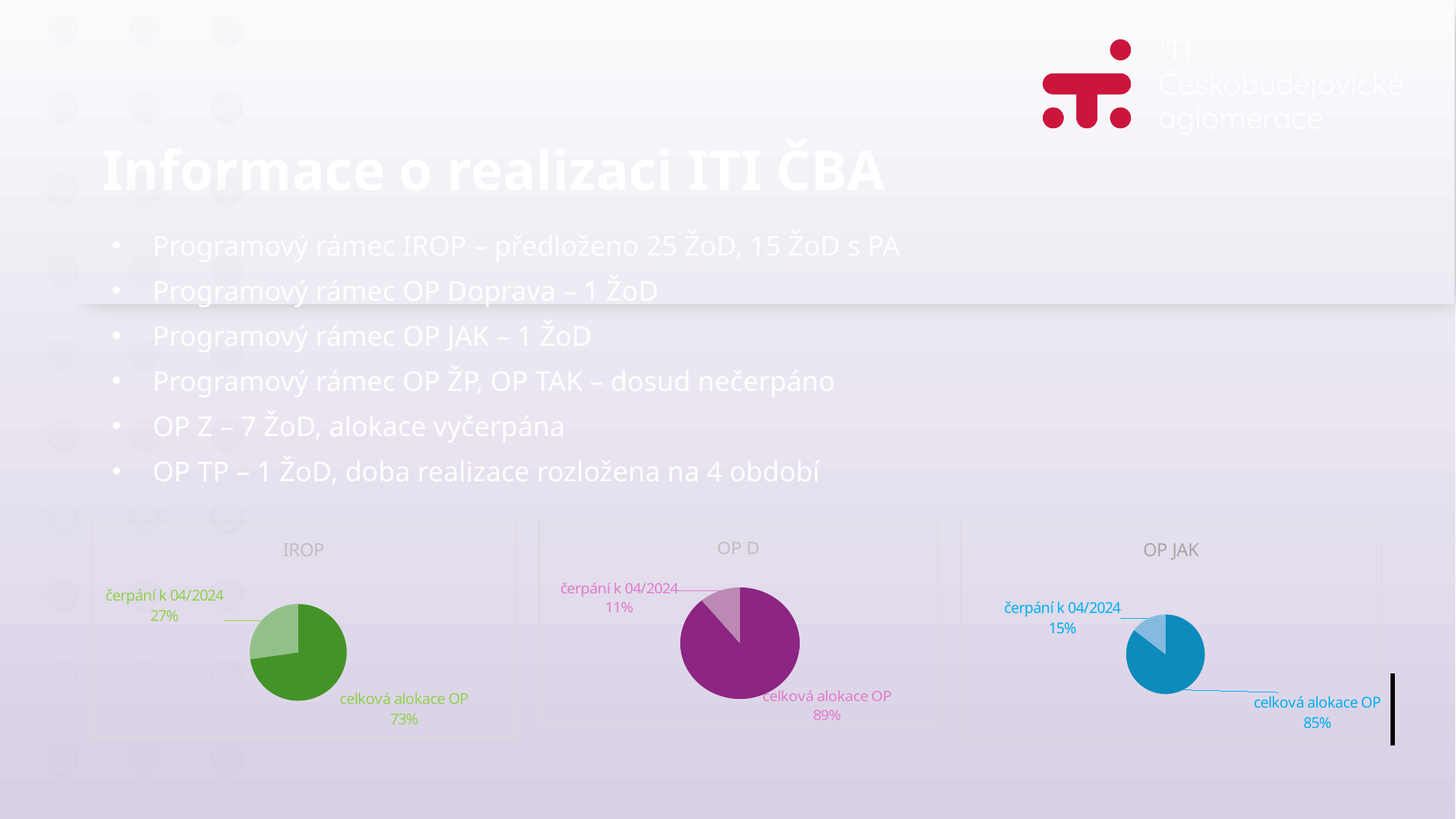
In the OP JAK chart, which slice is the largest? celková alokace OP In the OP JAK chart, what share does the slice 'celková alokace OP' have? 85% In the IROP chart, what share does the slice 'čerpání k 04/2024' have? 27% In the OP D chart, what share does the slice 'celková alokace OP' have? 89% In the OP D chart, what is the difference between the 'celková alokace OP' share and the 'čerpání k 04/2024' share? 78% What kind of chart is the IROP chart? Pie chart In the IROP chart, which slice is the smallest? čerpání k 04/2024 How many slices does the OP D chart have? 2 Which chart has the larger 'čerpání k 04/2024' share, the IROP chart or the OP JAK chart? IROP